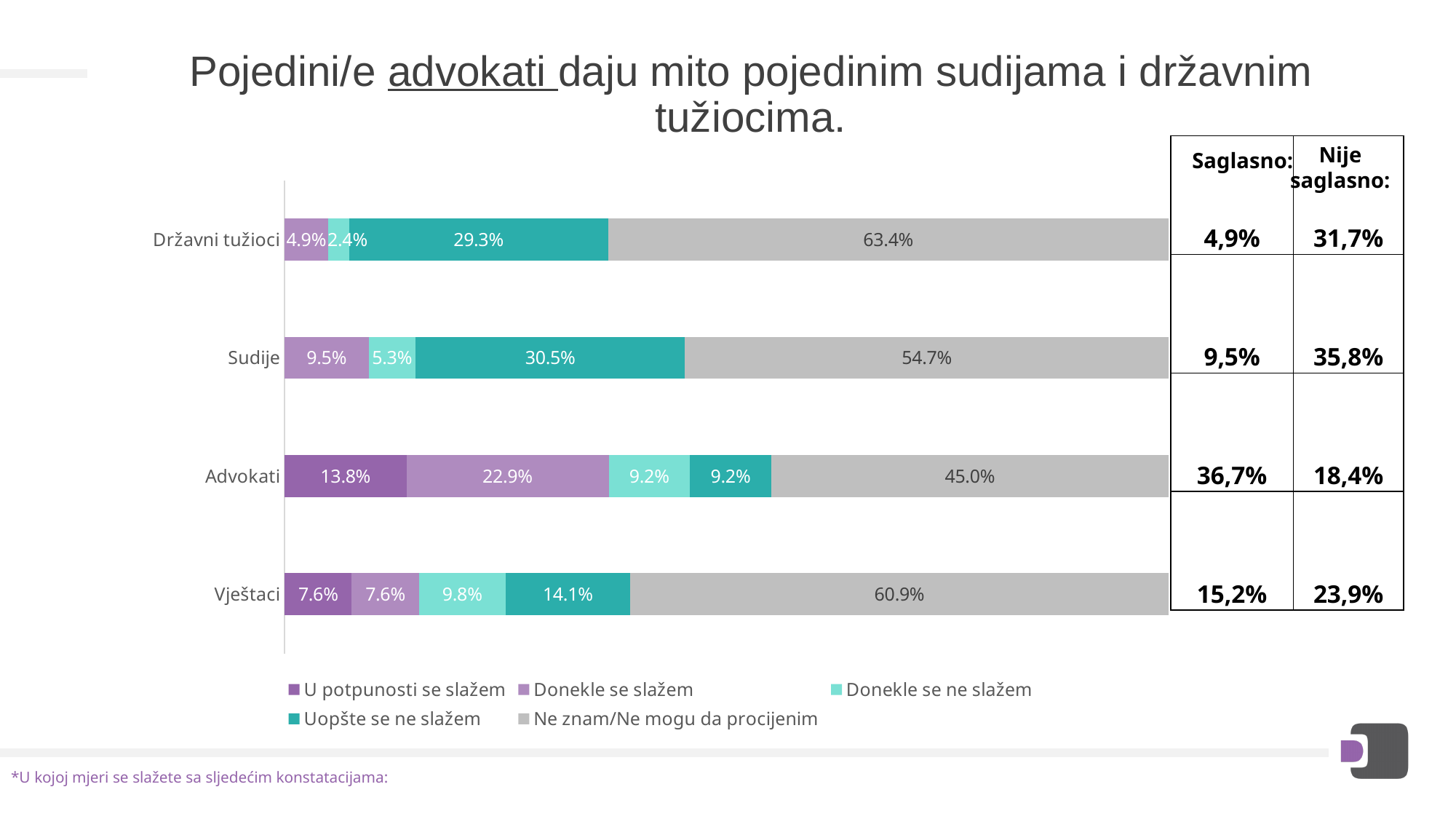
What is the difference between the 'Donekle se slažem' values for Advokati and Sudije? 13.4% What is the value of 'U potpunosti se slažem' for Advokati? 13.8% How many categories (respondent groups) are shown on the chart? 4 What is the value of 'Uopšte se ne slažem' for Sudije? 30.5% How many series does the legend list? 5 Which legend entry is shown in the darkest purple colour? U potpunosti se slažem What is the value of 'Donekle se ne slažem' for Vještaci? 9.8% What is the value of 'Ne znam/Ne mogu da procijenim' for Državni tužioci? 63.4% Which category has the lowest value for 'Ne znam/Ne mogu da procijenim'? Advokati Which is larger: the 'Uopšte se ne slažem' value for Državni tužioci or for Vještaci? Državni tužioci Which category has the highest value for 'Ne znam/Ne mogu da procijenim'? Državni tužioci What type of chart is shown on the slide? stacked bar chart